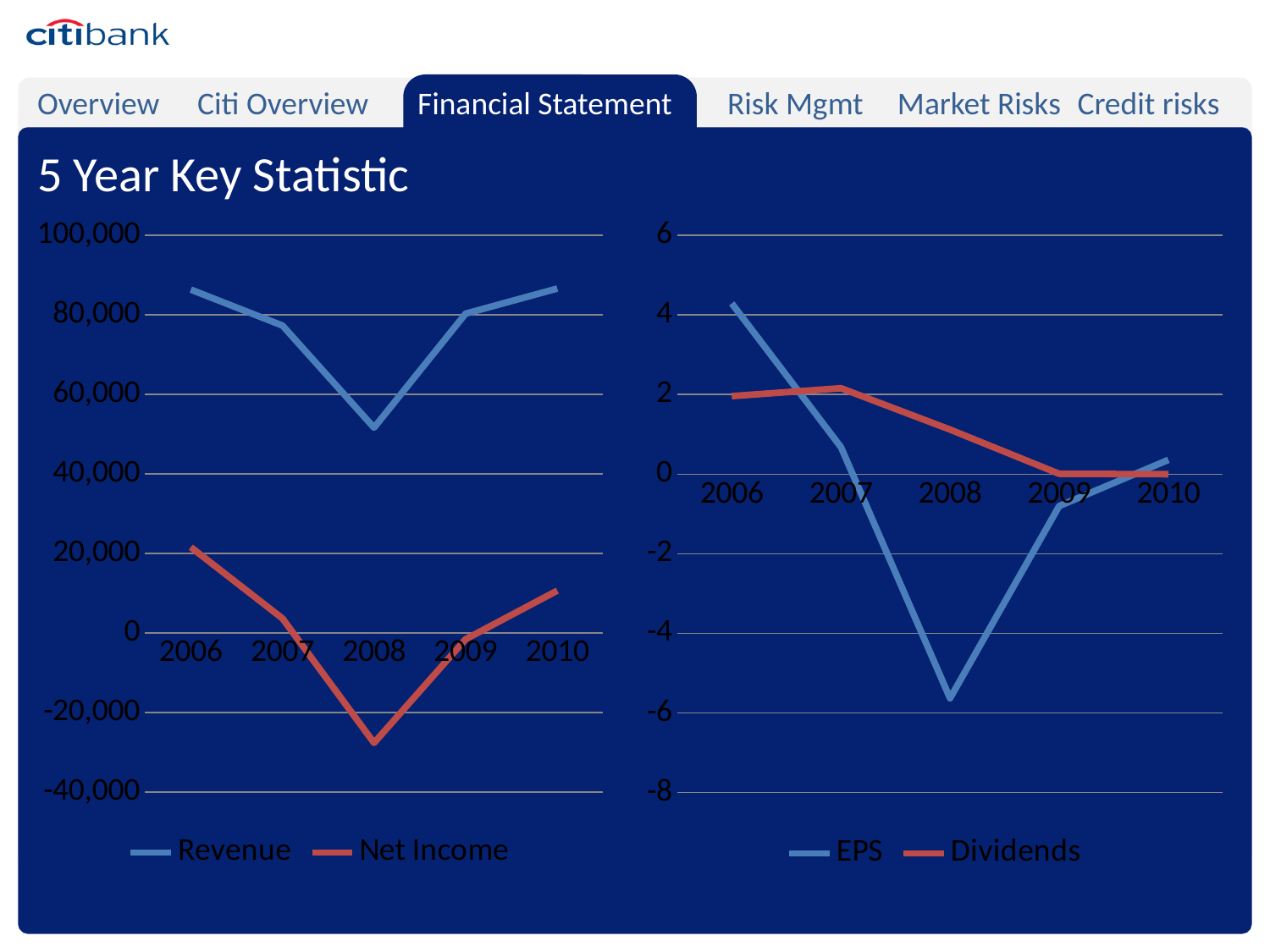
In the right chart, does the Dividends line rise or fall from 2007 to 2009? fall What is the title of the slide containing the two charts? 5 Year Key Statistic In the left chart, in which year is Net Income lowest? 2008 How many years are plotted on the x axis of the left chart? 5 In the right chart, which is larger in 2006, EPS or Dividends? EPS In the right chart, in which year is EPS highest? 2006 How many series does the legend of the right chart list? 2 What kind of chart is the left chart with Revenue and Net Income? line chart In the right chart, is the EPS value for 2008 greater or less than -4? less In the right chart, in which year is EPS lowest? 2008 In the left chart, is the Revenue value for 2008 greater or less than 60,000? less In the left chart, in which year is Revenue lowest? 2008